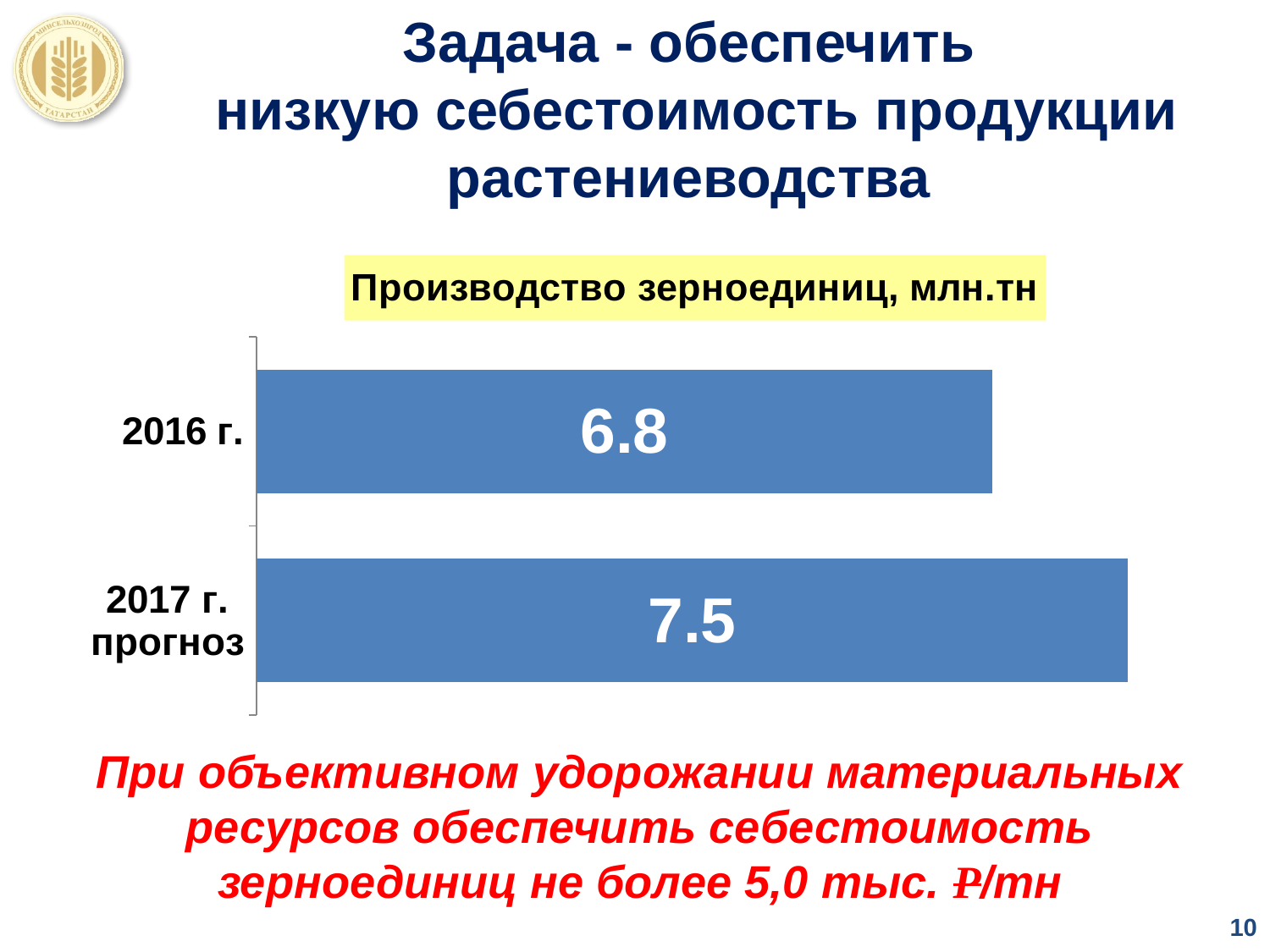
What colour are the bars in the chart? blue What is the difference between the values for 2017 г. прогноз and 2016 г.? 0.7 How many categories are shown in the chart? 2 What is the value for 2017 г. прогноз? 7.5 Which is larger, the value for 2016 г. or the value for 2017 г. прогноз? 2017 г. прогноз Which category has the highest value? 2017 г. прогноз What is the value for 2016 г.? 6.8 Which category has the lowest value? 2016 г. What is the title of the chart? Производство зерноединиц, млн.тн Do the values rise or fall from 2016 г. to 2017 г. прогноз? rise What kind of chart is shown on the slide? bar chart